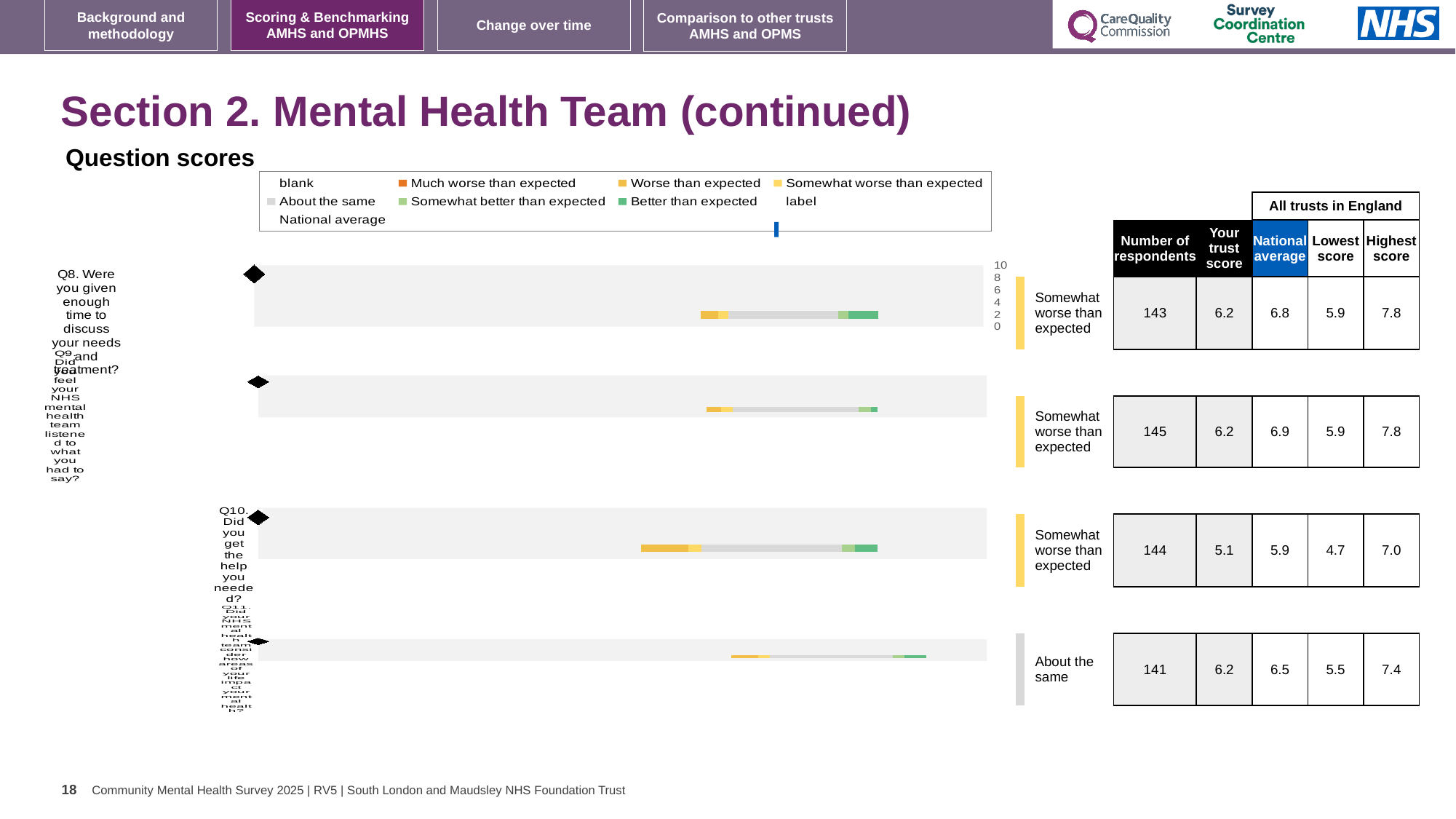
In the table beside the chart, what is the difference between the Highest score and the Lowest score for Q11? 1.9 In the table beside the chart, how many respondents are listed for Q9? 145 What kind of chart is shown under the heading 'Question scores'? bar chart In the table beside the chart, what is the 'Your trust score' for Q8 (Were you given enough time to discuss your needs and treatment?)? 6.2 How many entries does the legend of the 'Question scores' chart list? 9 What is the heading printed above the chart on this slide? Question scores How many question bars (Q8 to Q11) are plotted in the 'Question scores' chart? 4 What benchmark label is shown next to the Q11 bar in the chart? About the same In the table beside the chart, is the National average for Q8 larger or smaller than the National average for Q9? smaller Which legend entry in the 'Question scores' chart is shown in grey? About the same In the table beside the chart, which question row has the lowest 'Your trust score'? Q10 In the table beside the chart, what is the National average for Q10 (Did you get the help you needed?)? 5.9